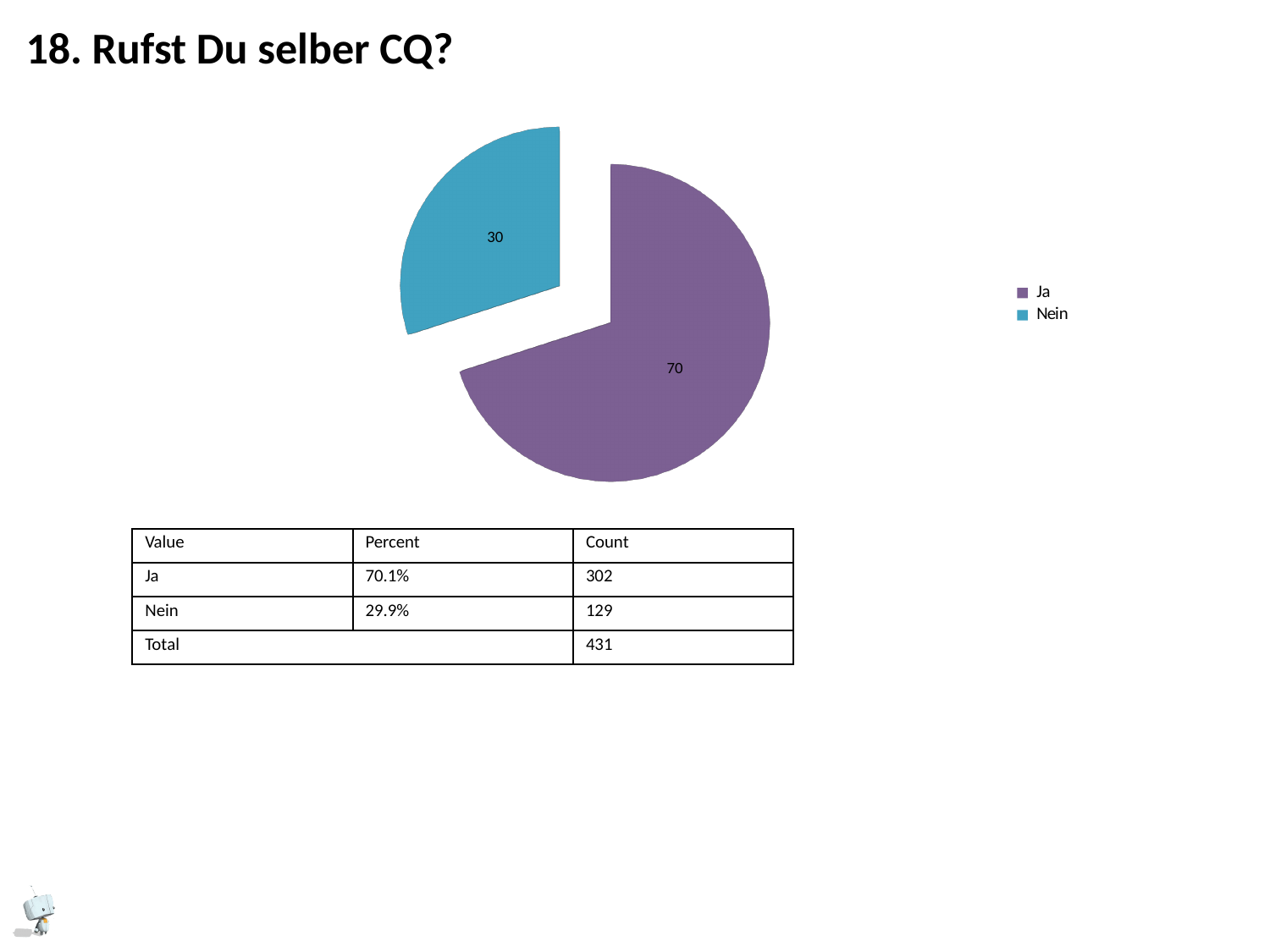
Which slice of the pie chart is the smallest? Nein Which slice is larger, Ja or Nein? Ja What value is labelled on the Ja slice of the pie chart? 70 How many slices does the pie chart have? 2 What value is labelled on the Nein slice of the pie chart? 30 Which slice of the pie chart is the largest? Ja What is the title of the slide containing the pie chart? 18. Rufst Du selber CQ? What kind of chart is shown on the slide? pie chart What is the difference between the labelled values of the Ja and Nein slices? 40 How many entries does the legend list? 2 Is the labelled value for the Ja slice greater or less than 50? greater What colour is the Nein slice in the pie chart? blue